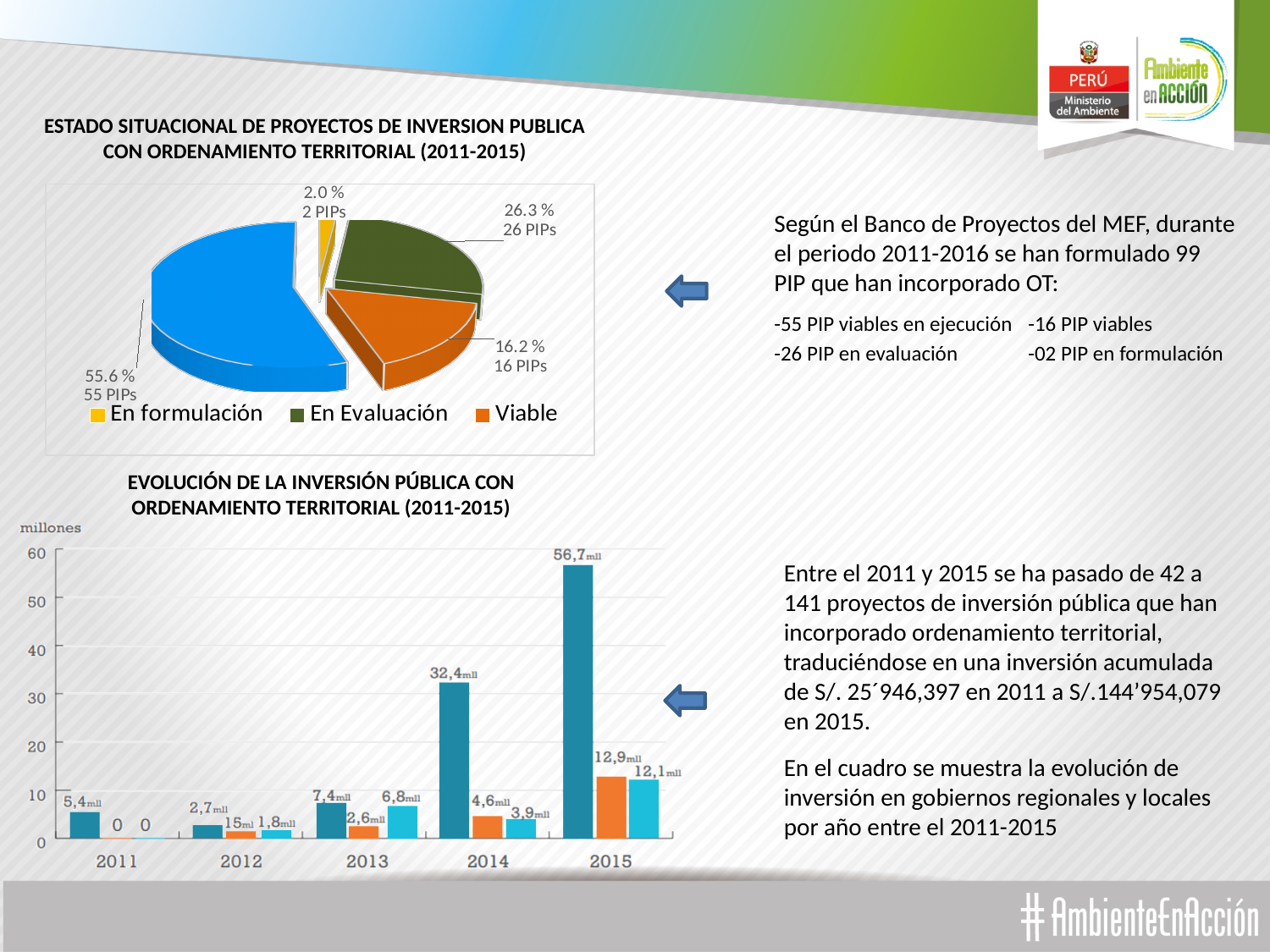
In the bar chart 'EVOLUCIÓN DE LA INVERSIÓN PÚBLICA', what is the value of the dark teal bar for 2014? 32,4 mll How many entries does the legend of the pie chart 'ESTADO SITUACIONAL DE PROYECTOS DE INVERSION PUBLICA' list? 3 In the pie chart 'ESTADO SITUACIONAL DE PROYECTOS DE INVERSION PUBLICA', how many PIPs are in the 'En Evaluación' slice? 26 PIPs In the bar chart 'EVOLUCIÓN DE LA INVERSIÓN PÚBLICA', is the dark teal bar for 2015 greater or less than 50? greater In the bar chart 'EVOLUCIÓN DE LA INVERSIÓN PÚBLICA', how many years are shown on the x axis? 5 In the pie chart 'ESTADO SITUACIONAL DE PROYECTOS DE INVERSION PUBLICA', how many PIPs are in the 'En formulación' slice? 2 PIPs In the pie chart 'ESTADO SITUACIONAL DE PROYECTOS DE INVERSION PUBLICA', how many more PIPs are 'En Evaluación' than 'Viable'? 10 PIPs In the pie chart 'ESTADO SITUACIONAL DE PROYECTOS DE INVERSION PUBLICA', what percentage share does the 'Viable' slice have? 16.2 % In the pie chart 'ESTADO SITUACIONAL DE PROYECTOS DE INVERSION PUBLICA', what is the percentage of the largest (blue) slice? 55.6 % What type of chart is 'EVOLUCIÓN DE LA INVERSIÓN PÚBLICA CON ORDENAMIENTO TERRITORIAL (2011-2015)'? bar chart In the bar chart 'EVOLUCIÓN DE LA INVERSIÓN PÚBLICA', which year has the highest bar? 2015 In the bar chart 'EVOLUCIÓN DE LA INVERSIÓN PÚBLICA', what is the value of the tallest (dark teal) bar for 2015? 56,7 mll